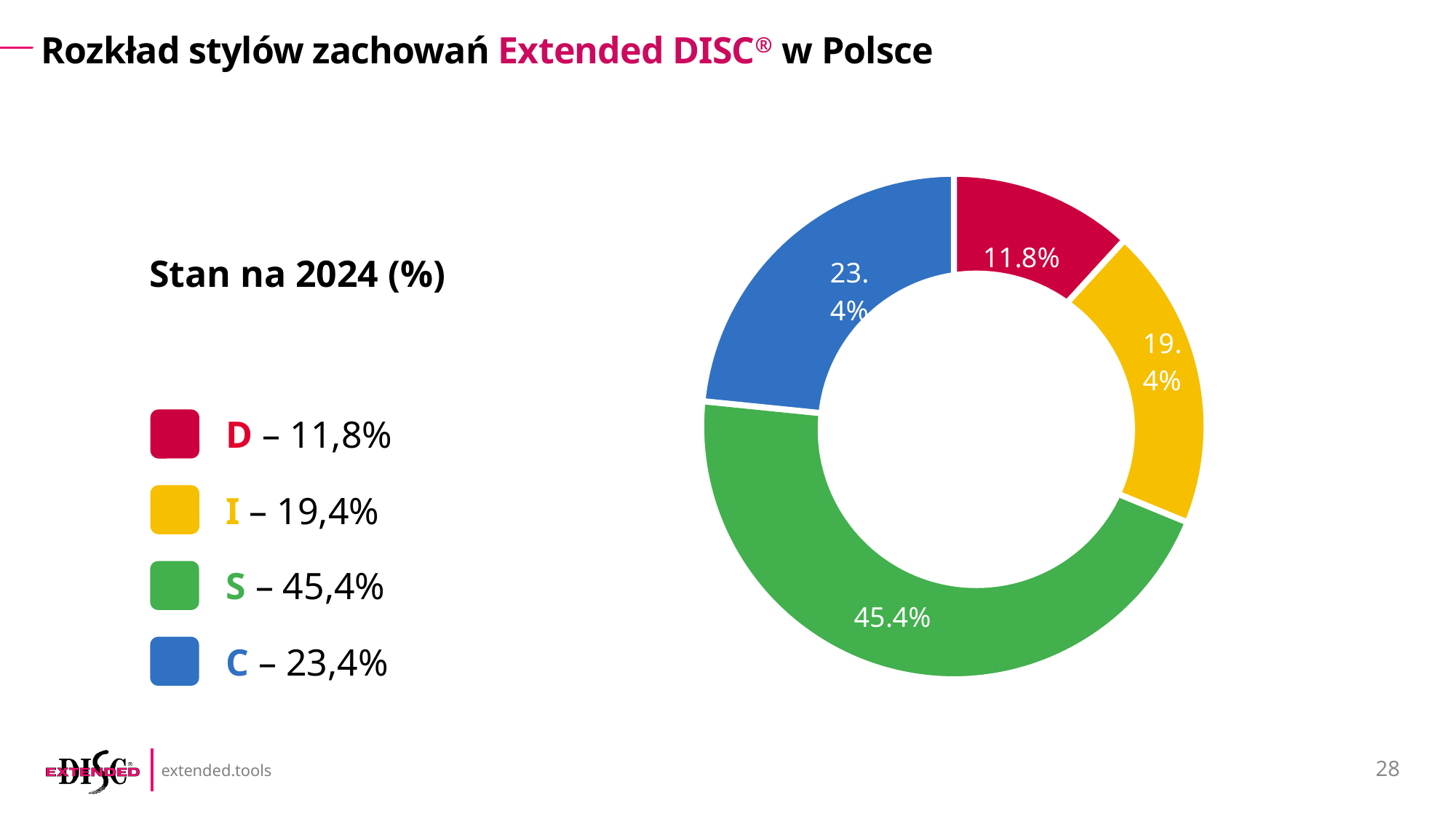
Which style has the smallest share of the chart? D What is the difference in percentage points between the S slice and the C slice? 22 percentage points How many slices does the chart have? 4 What is the value shown for the I (yellow) slice? 19.4% Which style has the largest share of the chart? S What is the value shown for the D (red) slice? 11.8% What is the value shown for the S (green) slice? 45.4% What is the difference in percentage points between the I slice and the D slice? 7.6 percentage points What kind of chart is shown on the slide? Doughnut (pie) chart Which is larger, the share for C or the share for I? C What colour is the slice representing the S style? Green What is the value shown for the C (blue) slice? 23.4%